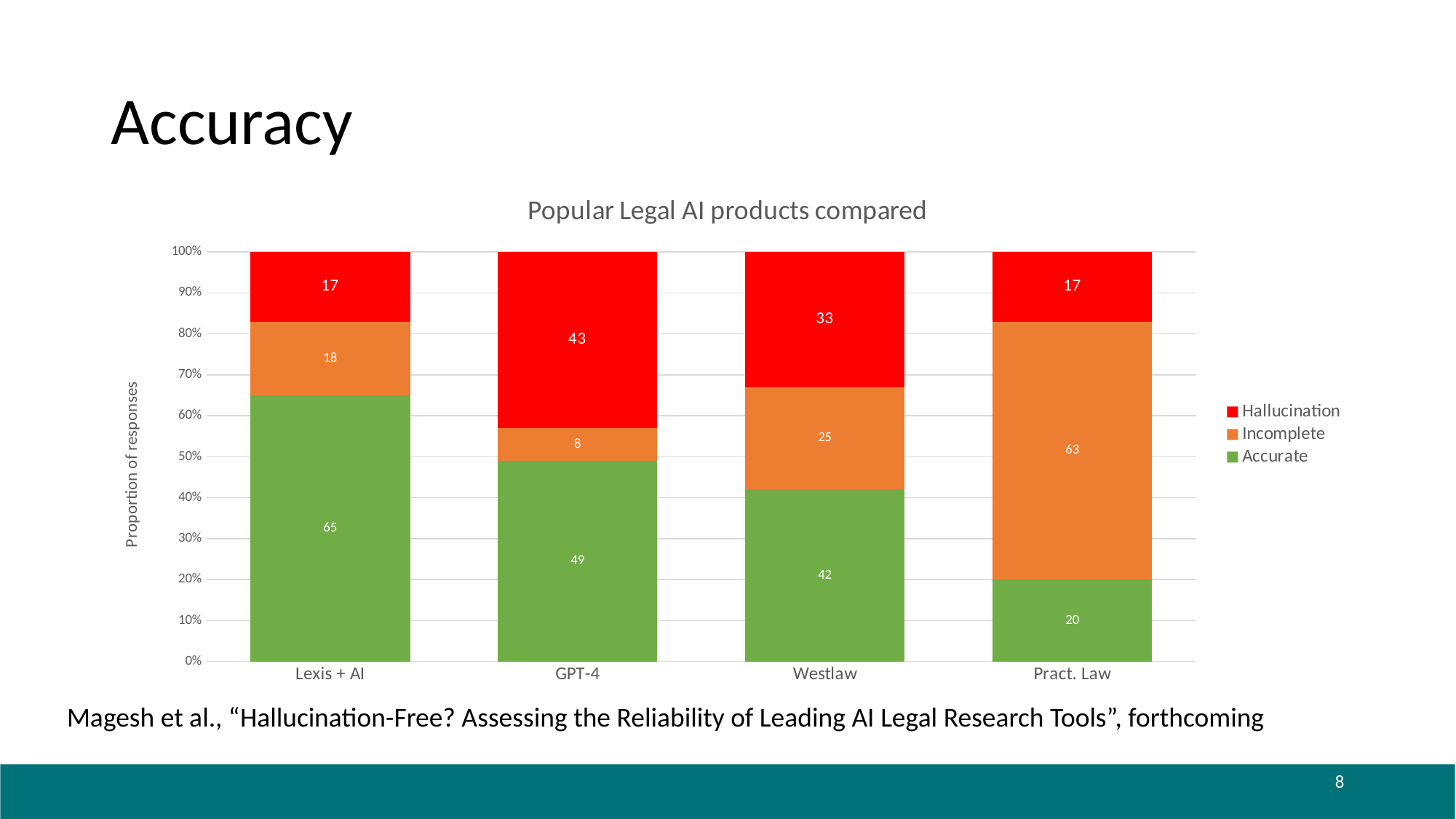
What is the difference between the Hallucination values for GPT-4 and Westlaw? 10 What is the Hallucination value for GPT-4? 43 Which product has the lowest Incomplete value? GPT-4 How many products are compared on the x axis? 4 What is the Incomplete value for Pract. Law? 63 Which product has the highest Accurate value? Lexis + AI Which is larger, the Accurate value for Westlaw or the Accurate value for Pract. Law? Westlaw What kind of chart is shown on the slide? Stacked bar chart What is the title of the chart? Popular Legal AI products compared How many series does the legend list? 3 What is the Accurate value for Lexis + AI? 65 What is the Incomplete value for Westlaw? 25